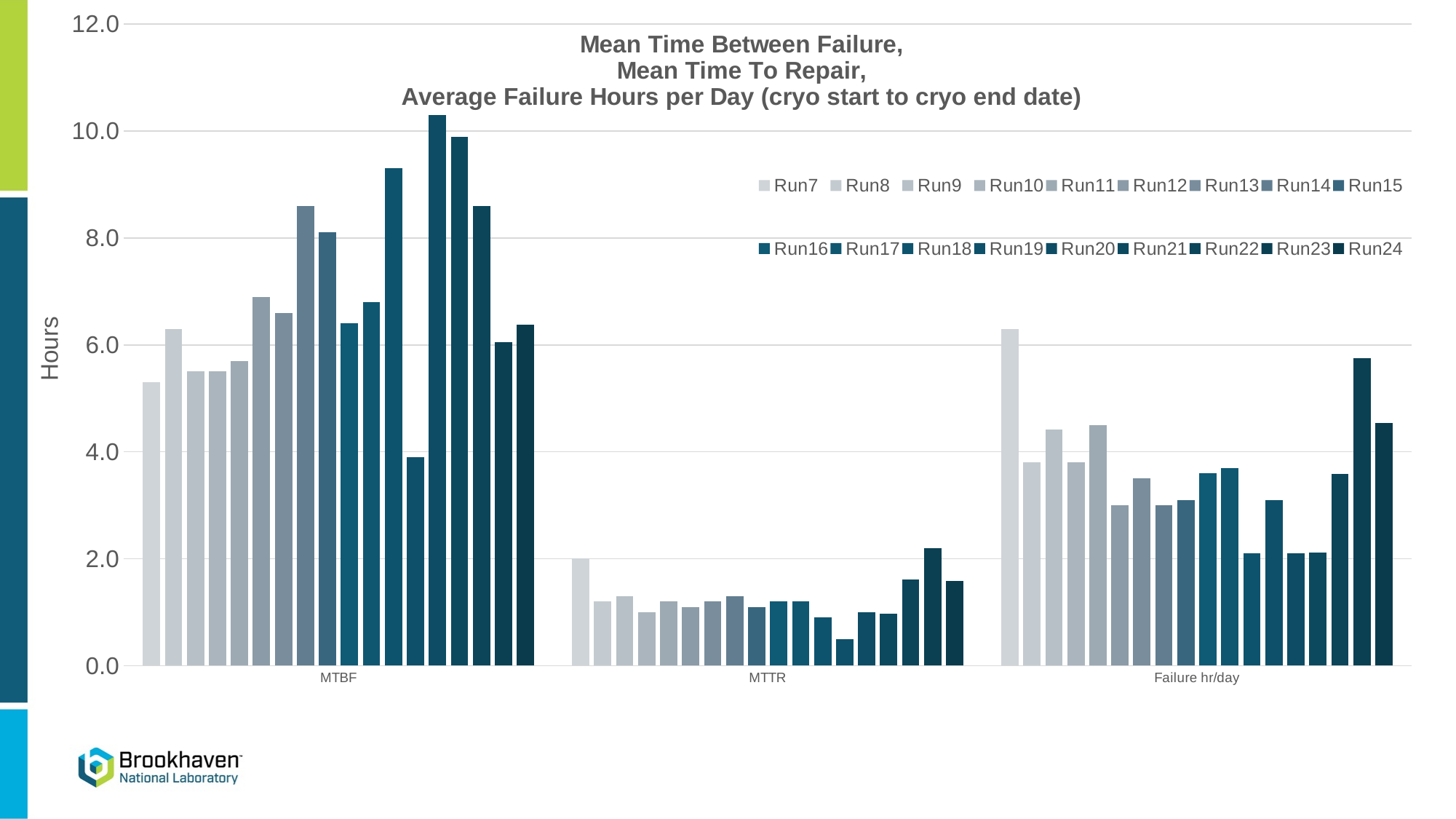
Is the Run24 value for Failure hr/day greater or less than 4.0? greater Which category has the lowest bars overall? MTTR Which category contains the tallest bar in the chart? MTBF Is the Run7 value for MTTR greater or less than 1.0? greater What is the highest value shown on the y axis? 12.0 Is the Run24 value for MTTR greater or less than 2.0? less What is the label of the y axis? Hours What kind of chart is shown on the slide? bar chart How many categories are shown on the x axis? 3 How many series does the legend list? 18